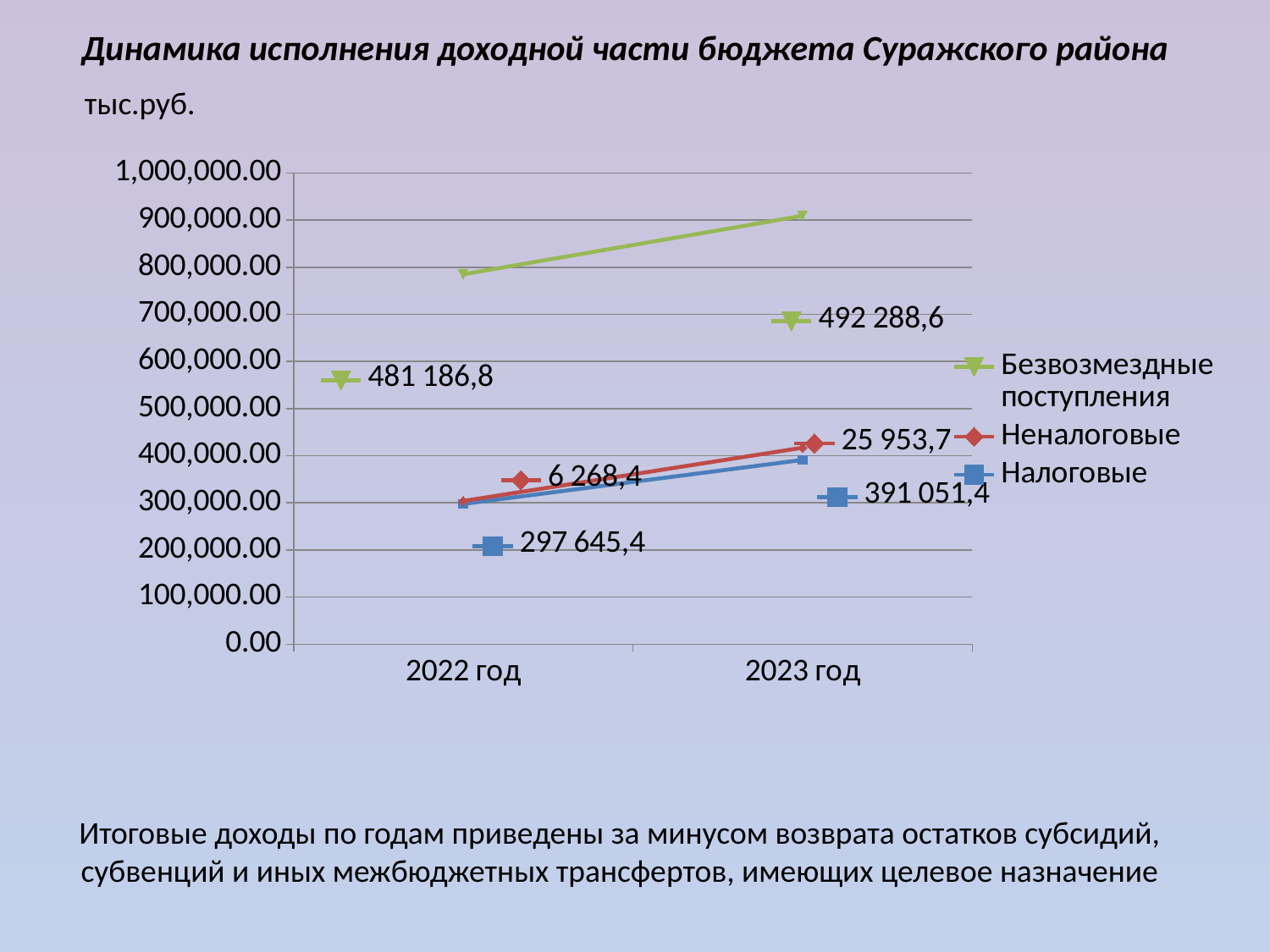
Which series has the lowest labelled value in 2022 год? Неналоговые Which series has the highest labelled value in 2023 год? Безвозмездные поступления How many series does the legend list? 3 What kind of chart is shown on the slide? line chart Do the labelled values for Неналоговые rise or fall from 2022 год to 2023 год? rise What is the labelled value for Безвозмездные поступления in 2023 год? 492 288,6 By how much does the labelled value for Налоговые in 2023 год exceed that in 2022 год? 93 406,0 How many years are shown on the x axis? 2 What is the labelled value for Неналоговые in 2022 год? 6 268,4 In what unit are the values on the chart given, according to the slide? тыс.руб. What is the labelled value for Налоговые in 2023 год? 391 051,4 What is the labelled value for Безвозмездные поступления in 2022 год? 481 186,8